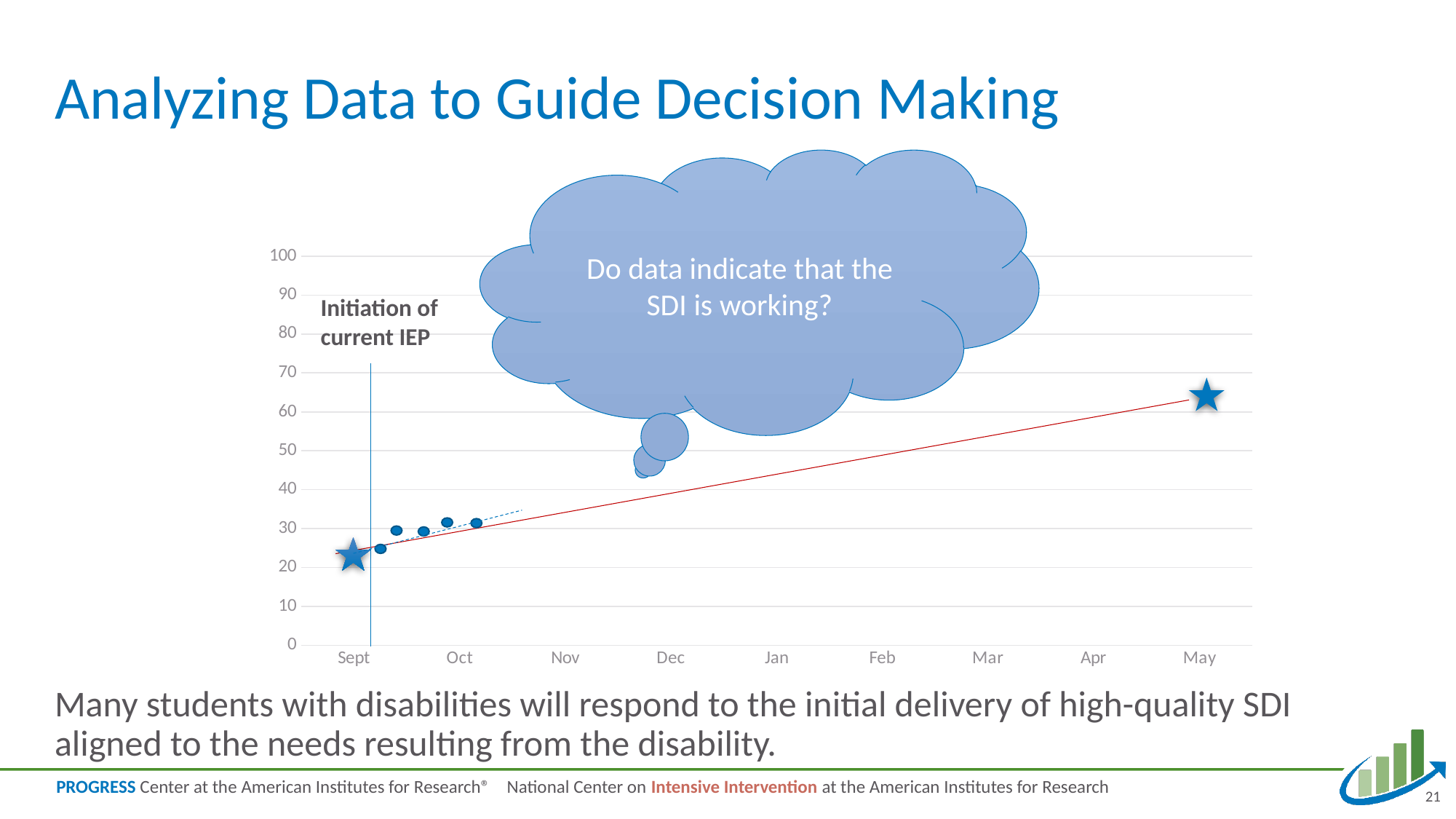
What is the highest value shown on the y axis of the chart? 100 How many month labels are shown along the x axis of the chart? 9 Do the plotted data points rise or fall from Sept toward Oct? rise Is the value of the star marker at Sept greater or less than 30? less Is the value of the star marker at May greater or less than 60? greater Which star marker has the larger value, the one at Sept or the one at May? May What label appears next to the vertical line near Sept on the chart? Initiation of current IEP What is the first month label on the x axis of the chart? Sept What is the last month label on the x axis of the chart? May What question is written inside the thought bubble over the chart? Do data indicate that the SDI is working? What is the interval between consecutive tick marks on the y axis? 10 Are the plotted data points around Oct greater or less than 40? less